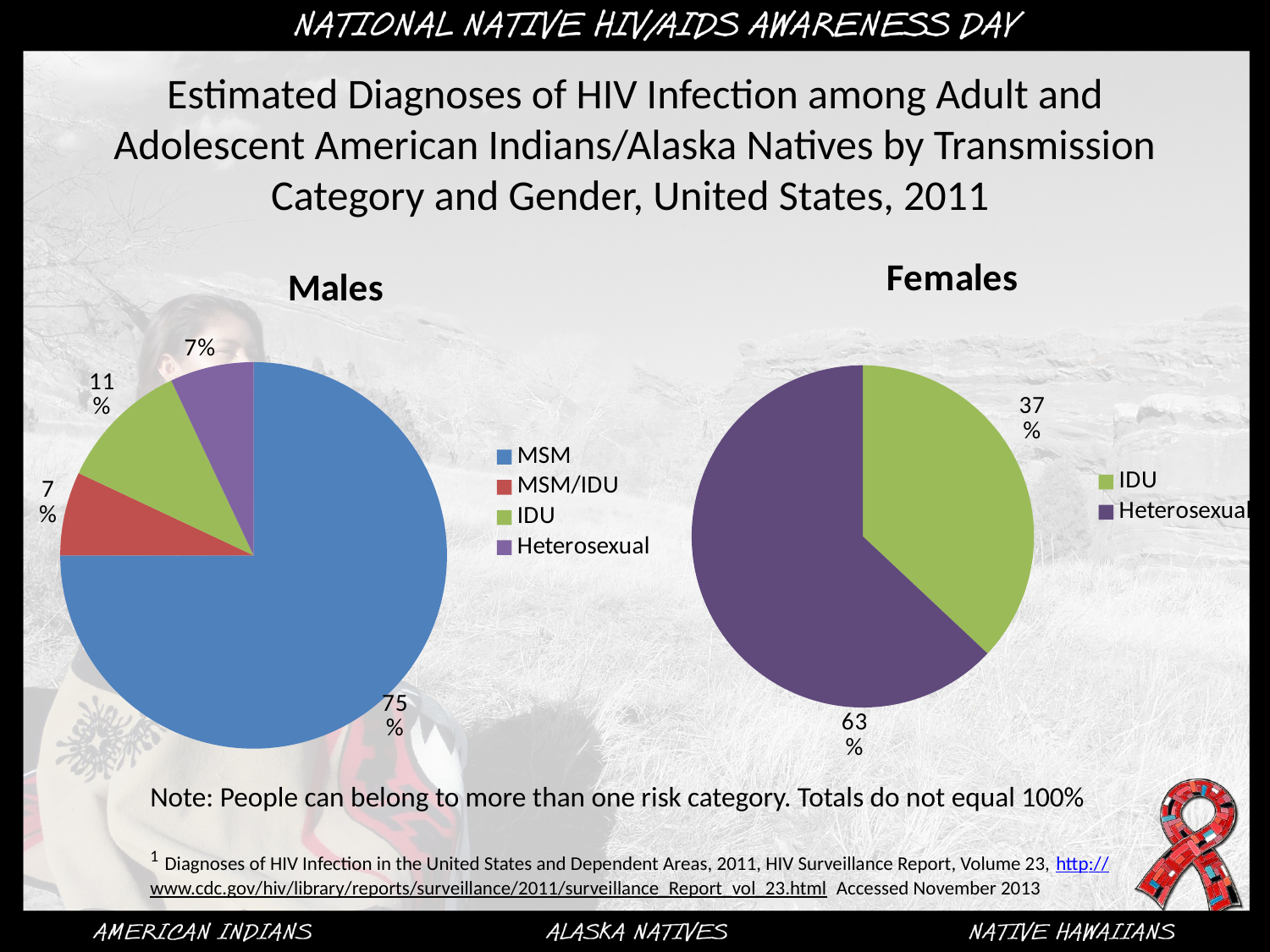
In the Females chart, what is the difference between the Heterosexual and IDU percentages? 26% What type of chart is used for the Males and Females data? Pie chart How many transmission categories does the legend of the Males chart list? 4 In the Females chart, what percentage is shown for Heterosexual? 63% In the Males chart, what percentage is shown for IDU? 11% In the Males chart, which is larger, the IDU slice or the Heterosexual slice? IDU How many transmission categories does the legend of the Females chart list? 2 In the Males chart, what percentage is shown for MSM? 75% In the Males chart, what is the difference between the MSM and IDU percentages? 64% In the Females chart, which transmission category has the smaller slice? IDU In the Males chart, which transmission category has the largest slice? MSM In the Females chart, what percentage is shown for IDU? 37%